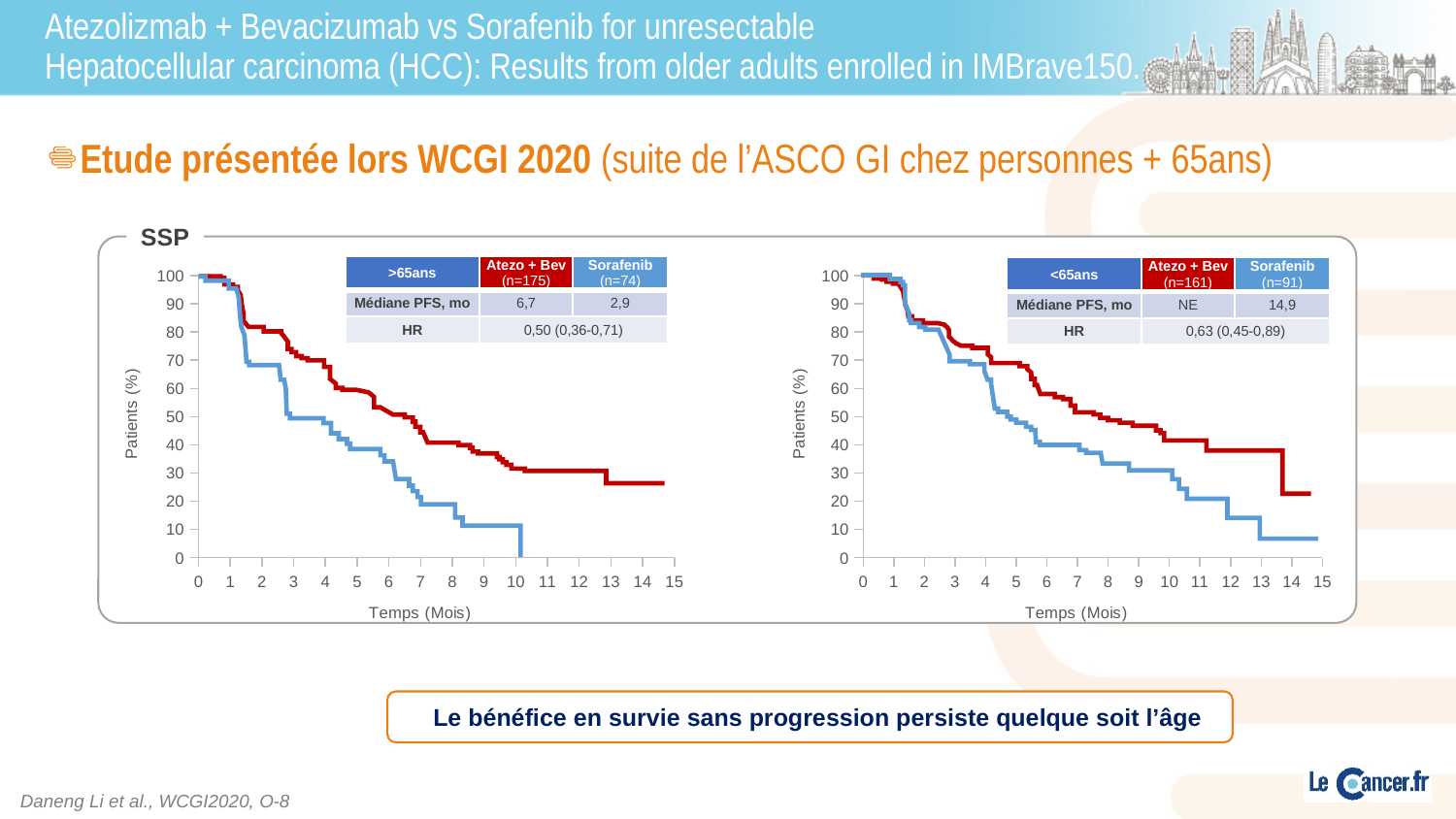
In the left chart (>65ans), what is the median PFS in months for Sorafenib? 2,9 In the left chart (>65ans), what is the median PFS in months for Atezo + Bev? 6,7 In the right chart (<65ans), what is the median PFS in months for Sorafenib? 14,9 In the right chart (<65ans), what is the HR shown in the table? 0,63 (0,45-0,89) What is the label of the x axis in both charts? Temps (Mois) In the right chart (<65ans), is the Sorafenib (blue) curve at 14 months greater or less than 20%? less In the left chart (>65ans), is the Atezo + Bev (red) curve at 10 months greater or less than 20%? greater In the right chart (<65ans), do the curves rise or fall as time (months) increases? fall In the left chart (>65ans), which curve is higher at 10 months, Atezo + Bev or Sorafenib? Atezo + Bev In the left chart (>65ans), what is the difference in median PFS (months) between Atezo + Bev and Sorafenib? 3,8 What kind of chart is shown on the left (>65ans) panel of the slide? line chart How many treatment curves are plotted in the left chart (>65ans)? 2